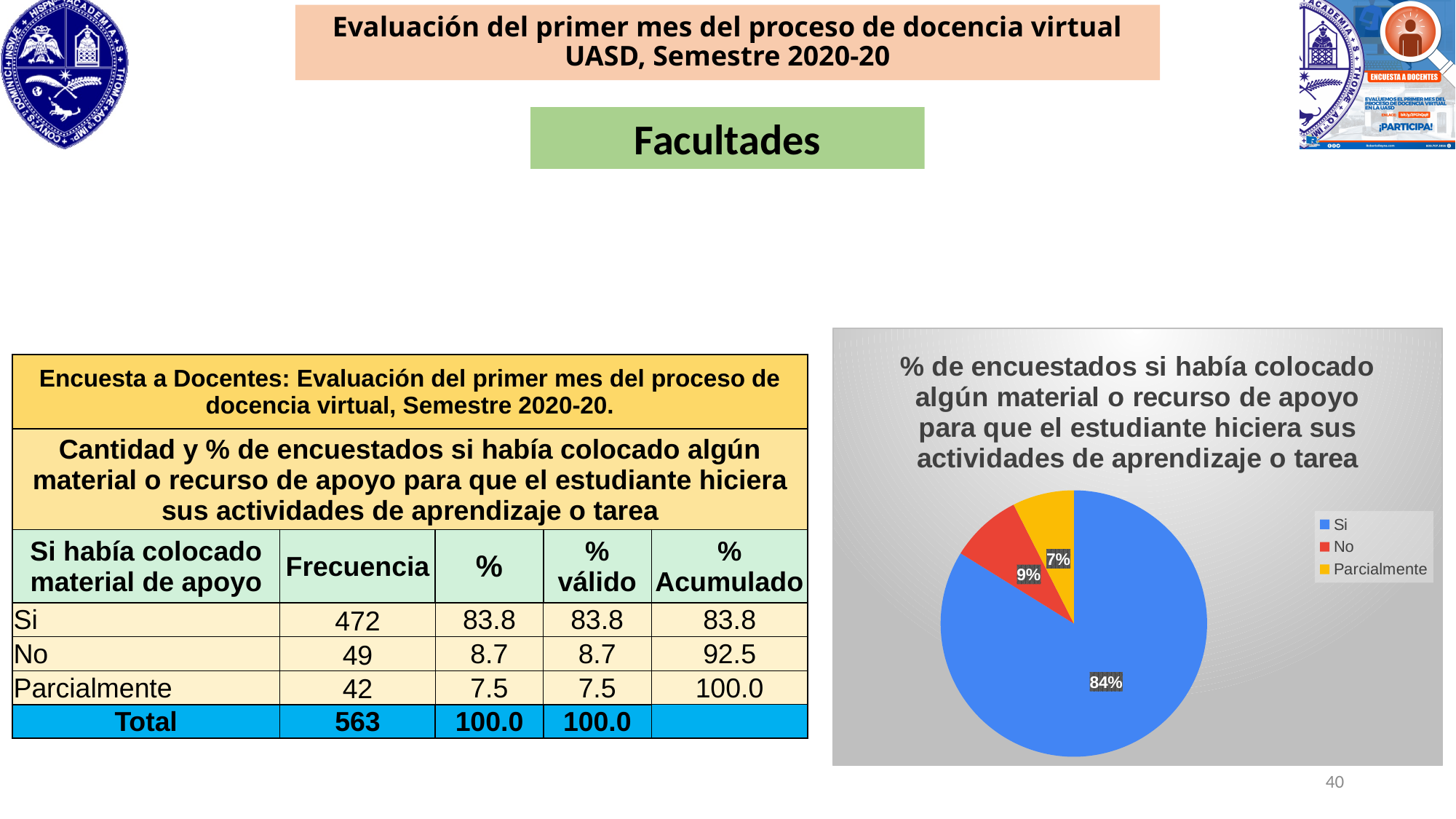
Which category has the largest slice in the pie chart? Si In the pie chart, what is the difference in percentage points between the "No" slice and the "Parcialmente" slice? 2 Which category has the smallest slice in the pie chart? Parcialmente In the pie chart, what percentage is shown for the "Si" slice? 84% In the pie chart, what percentage is shown for the "Parcialmente" slice? 7% How many entries does the pie chart's legend list? 3 How many slices does the pie chart have? 3 What colour is the "Parcialmente" slice in the pie chart? yellow In the pie chart, what is the difference in percentage points between the "Si" slice and the "No" slice? 75 In the pie chart, which slice is larger: "No" or "Parcialmente"? No What kind of chart is shown on the slide? pie chart In the pie chart, what percentage is shown for the "No" slice? 9%